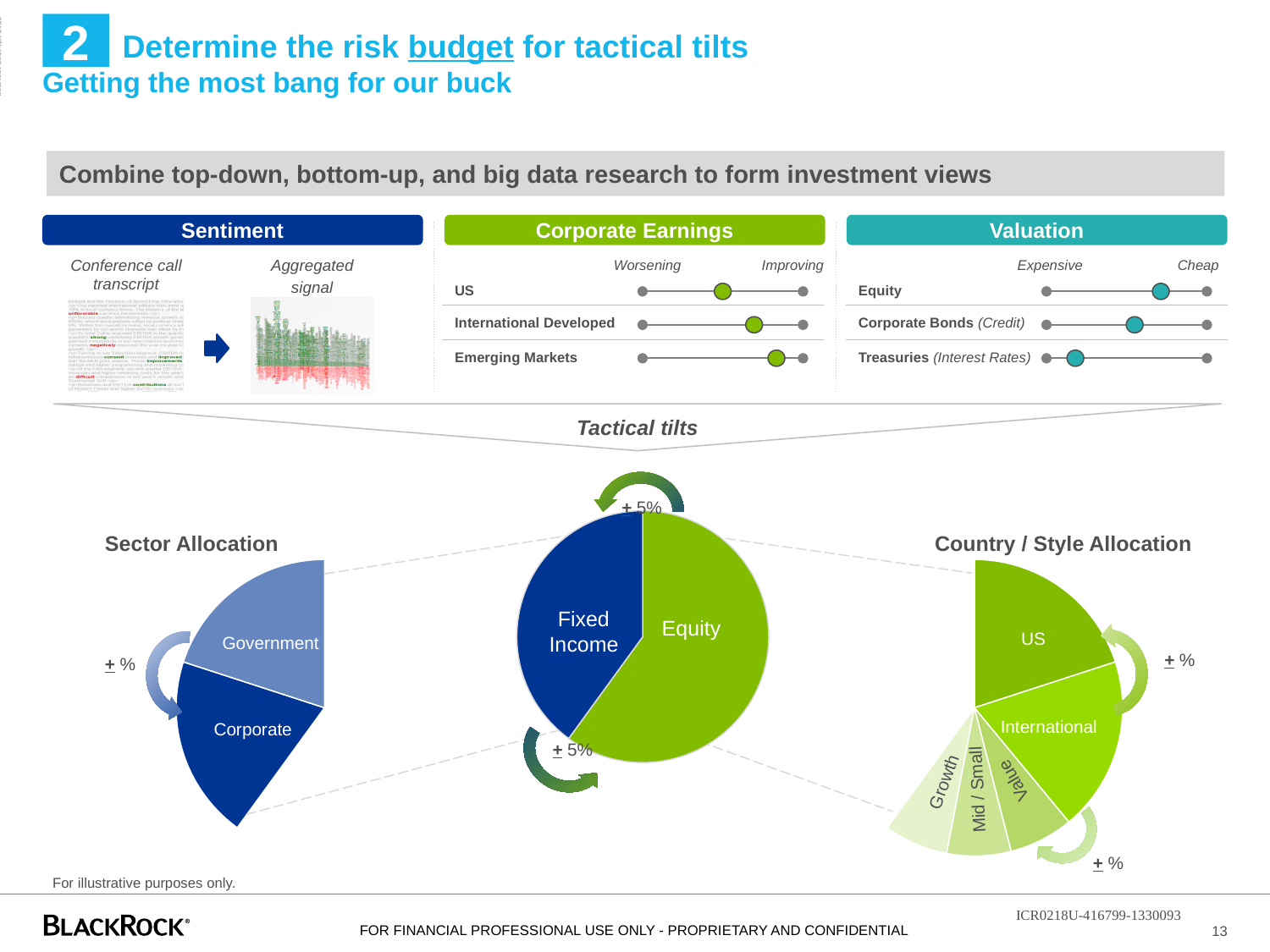
What kind of chart is the Sector Allocation chart? pie chart How many slices are shown in the Country / Style Allocation chart? 5 What are the two slices of the Sector Allocation chart labelled? Government and Corporate In the Country / Style Allocation chart, which is larger, the International slice or the Growth slice? International What tactical tilt range is labelled next to the central Fixed Income / Equity pie chart? ± 5% In the central pie chart, which slice is the largest? Equity In the Country / Style Allocation chart, which is larger, the US slice or the Value slice? US What kind of chart is the central chart labelled Fixed Income and Equity? pie chart How many slices does the central Fixed Income / Equity pie chart have? 2 In the central pie chart, which slice is larger, Equity or Fixed Income? Equity How many slices are shown in the Sector Allocation chart? 2